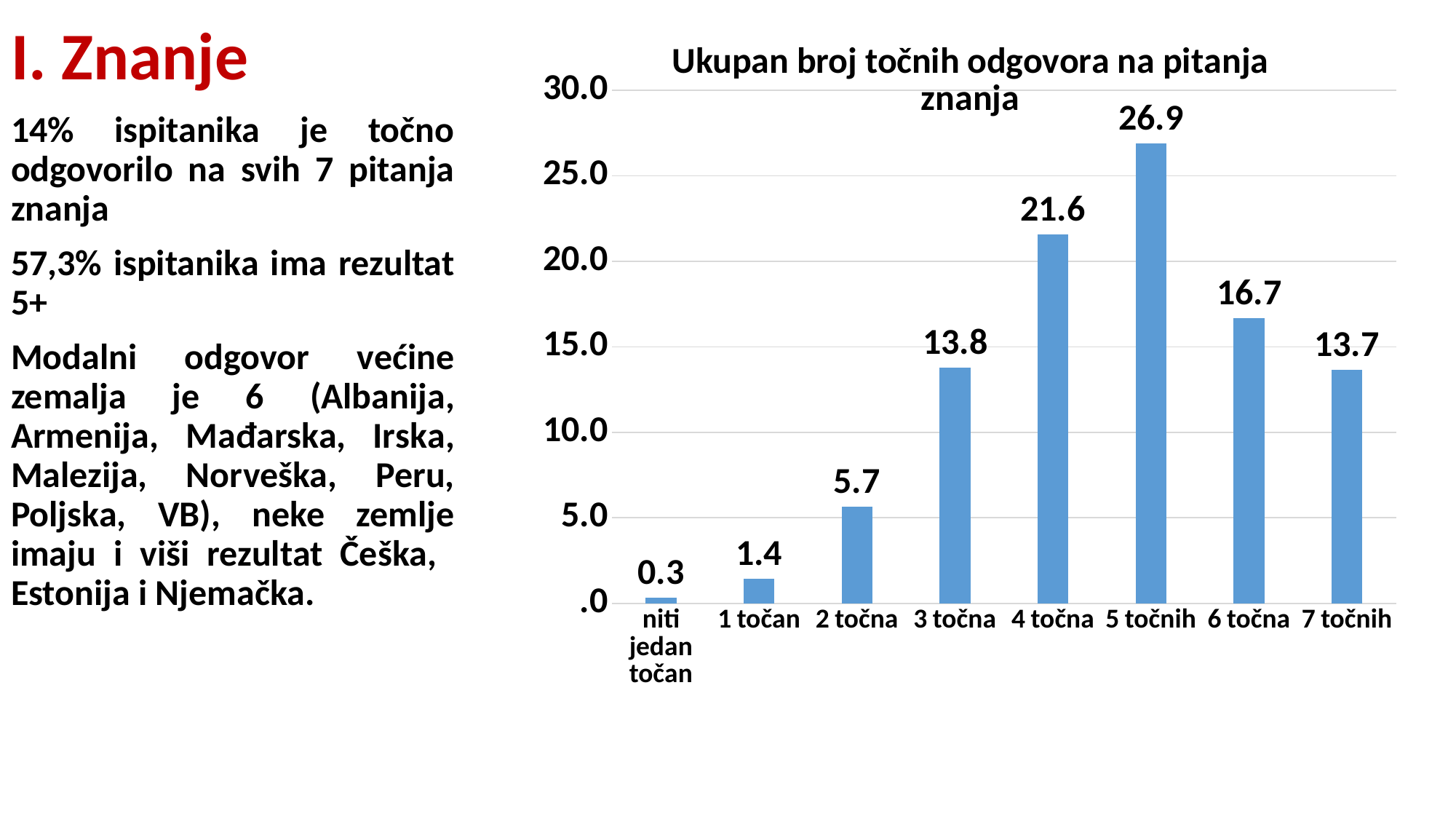
What is the value for "3 točna"? 13.8 What is the title of the chart? Ukupan broj točnih odgovora na pitanja znanja What kind of chart is shown? bar chart What is the value for "niti jedan točan"? 0.3 What is the difference between the values for "5 točnih" and "4 točna"? 5.3 Which category has the lowest value? niti jedan točan Do the values rise or fall from "niti jedan točan" to "5 točnih"? rise Which category has the highest value? 5 točnih How many categories are shown on the x axis? 8 Is the value for "4 točna" greater or less than 20.0? greater What is the value for "5 točnih"? 26.9 Which is larger, the value for "6 točna" or the value for "7 točnih"? 6 točna